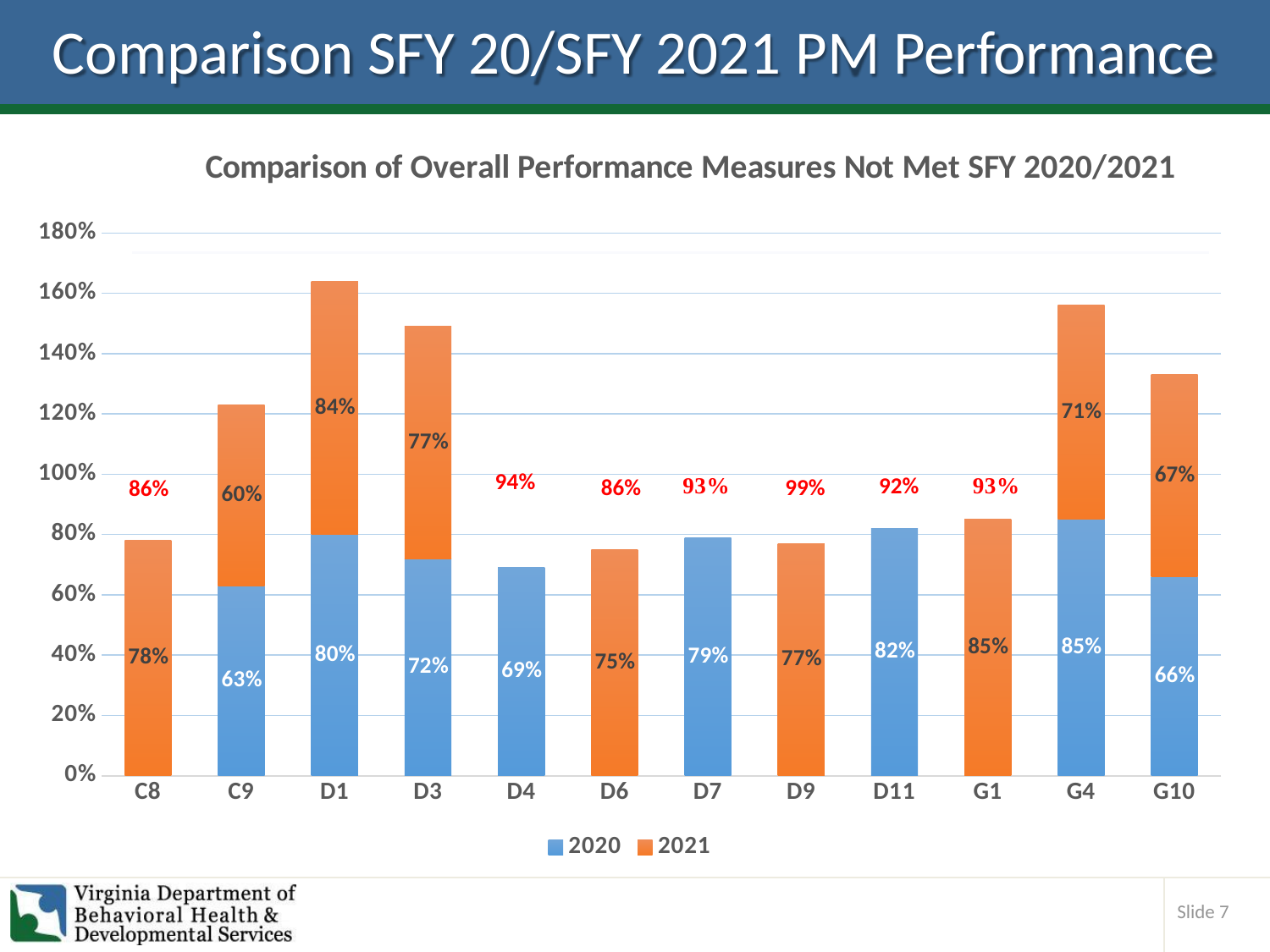
How many series does the legend list? 2 What is the difference between the 2021 and 2020 values for D3? 5% Which category has the tallest stacked bar? D1 How many categories are shown on the x axis? 12 For G4, which series has the larger value, 2020 or 2021? 2020 What is the 2021 value for G1? 85% What kind of chart is shown on the slide? Bar chart What is the 2020 value for C9? 63% What is the total of the stacked bar for C9? 123% What is the 2021 value for D1? 84% What is the 2020 value for G4? 85% What is the total of the stacked bar for D1? 164%